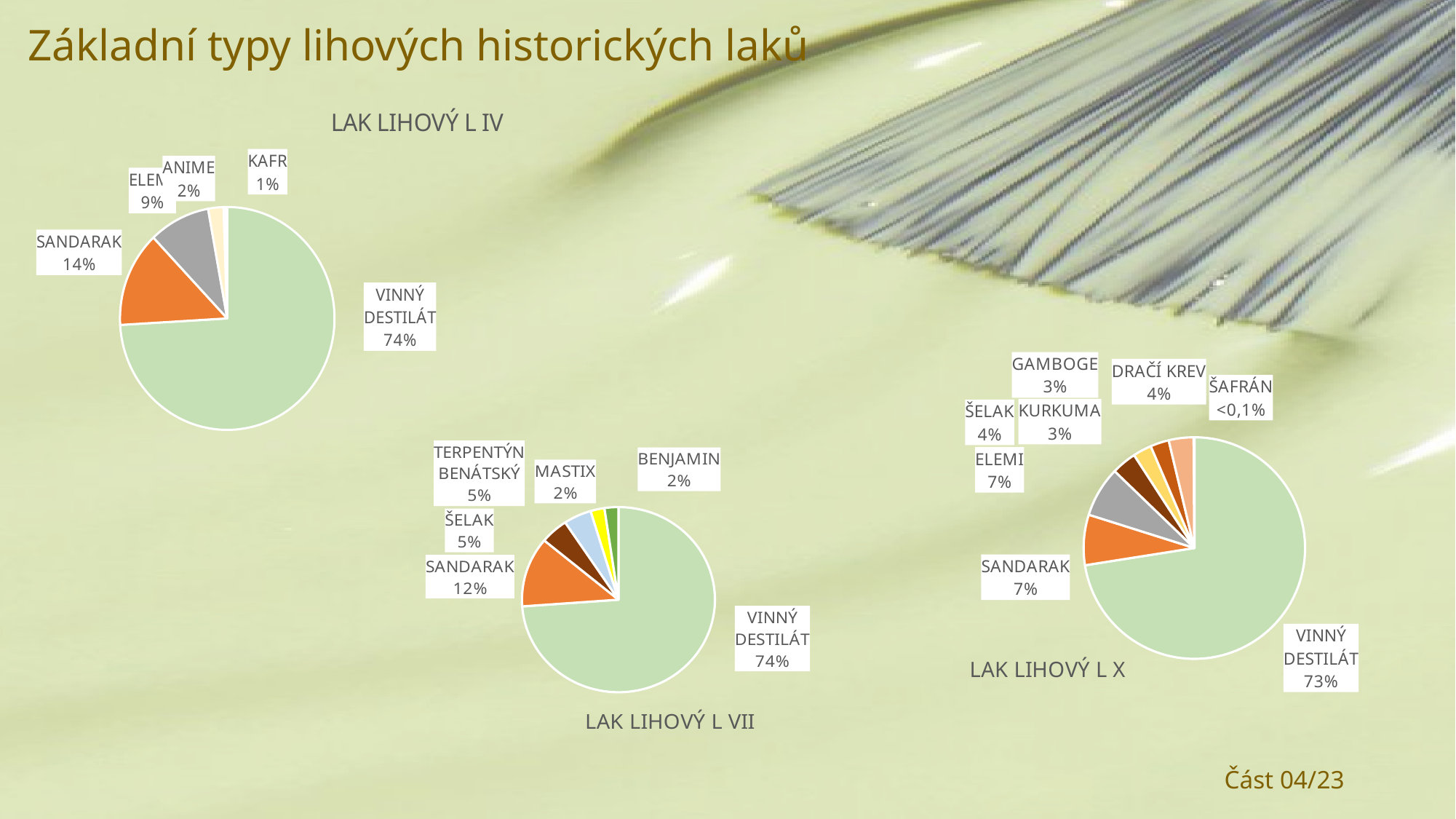
In the LAK LIHOVÝ L VII chart, what is the value for SANDARAK? 12% In the LAK LIHOVÝ L X chart, what share does VINNÝ DESTILÁT have? 73% In the LAK LIHOVÝ L VII chart, what is the difference between VINNÝ DESTILÁT and SANDARAK? 62% In the LAK LIHOVÝ L IV chart, which category has the smallest slice? KAFR What kind of chart is LAK LIHOVÝ L X? Pie chart In the LAK LIHOVÝ L IV chart, what is the value for SANDARAK? 14% In the LAK LIHOVÝ L VII chart, how many slices does the pie have? 6 In the LAK LIHOVÝ L IV chart, what share does VINNÝ DESTILÁT have? 74% In the LAK LIHOVÝ L X chart, what is the value for DRAČÍ KREV? 4% How many charts are shown on the slide? 3 In the LAK LIHOVÝ L X chart, which category has the largest slice? VINNÝ DESTILÁT In the LAK LIHOVÝ L X chart, what is the value for ŠAFRÁN? <0,1%